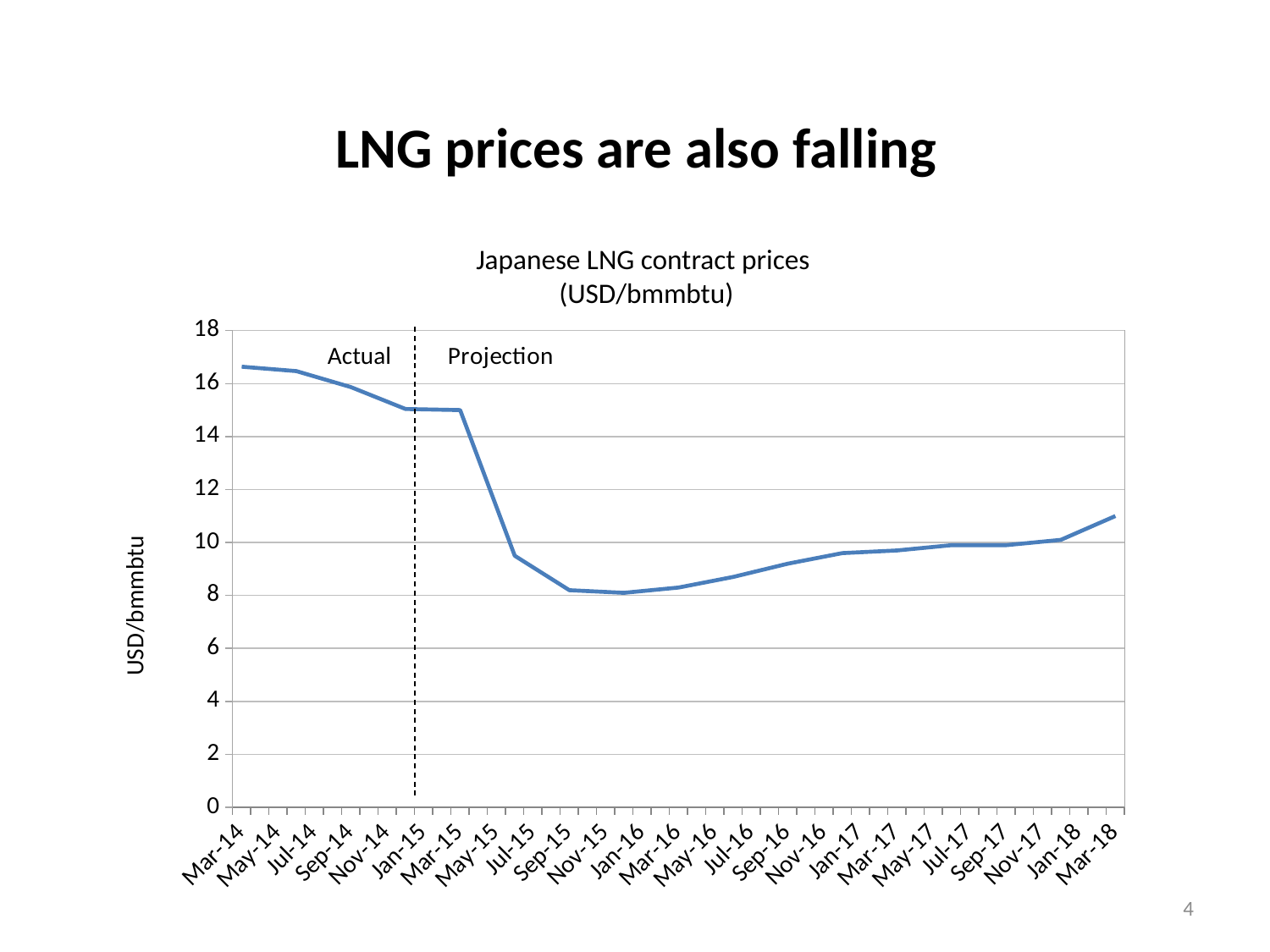
Which month has the highest LNG contract price in the chart? Mar-14 What two labels appear on either side of the dashed vertical line in the chart? Actual and Projection Which is larger, the value for Mar-14 or the value for Jan-16? Mar-14 What kind of chart is shown on the slide? Line chart What is the title of the chart? Japanese LNG contract prices (USD/bmmbtu) Is the value for Mar-18 greater or less than 10? greater Is the value for Mar-14 greater or less than 16? greater Does the LNG contract price rise or fall between Mar-14 and Jan-16? Fall Is the value for Mar-15 greater or less than 14? greater Does the LNG contract price rise or fall between Jan-16 and Mar-18? Rise